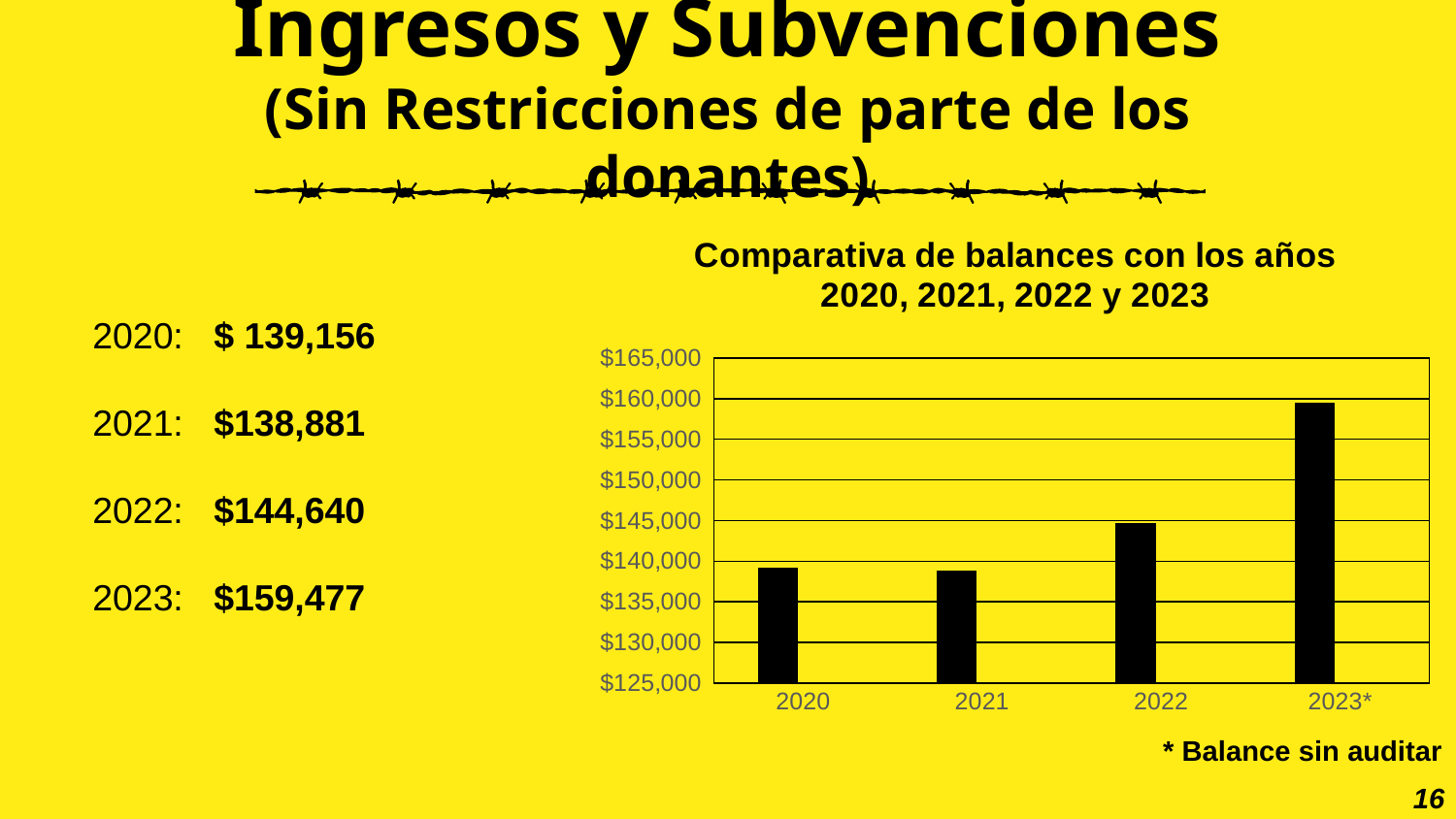
What is the difference between the 2023 value ($159,477) and the 2022 value ($144,640)? $14,837 Which year has the highest value in the chart? 2023* According to the slide, what is the value for 2022? $144,640 What kind of chart is shown on the slide? bar chart Which is larger, the value for 2022 or the value for 2023*? 2023* Is the value for 2022 greater or less than $140,000? greater According to the slide, what is the value for 2023? $159,477 What is the title of the chart? Comparativa de balances con los años 2020, 2021, 2022 y 2023 Is the value for 2021 greater or less than $140,000? less How many bars (years) does the chart show? 4 Is the value for 2023* greater or less than $155,000? greater Which year has the lowest value in the chart? 2021